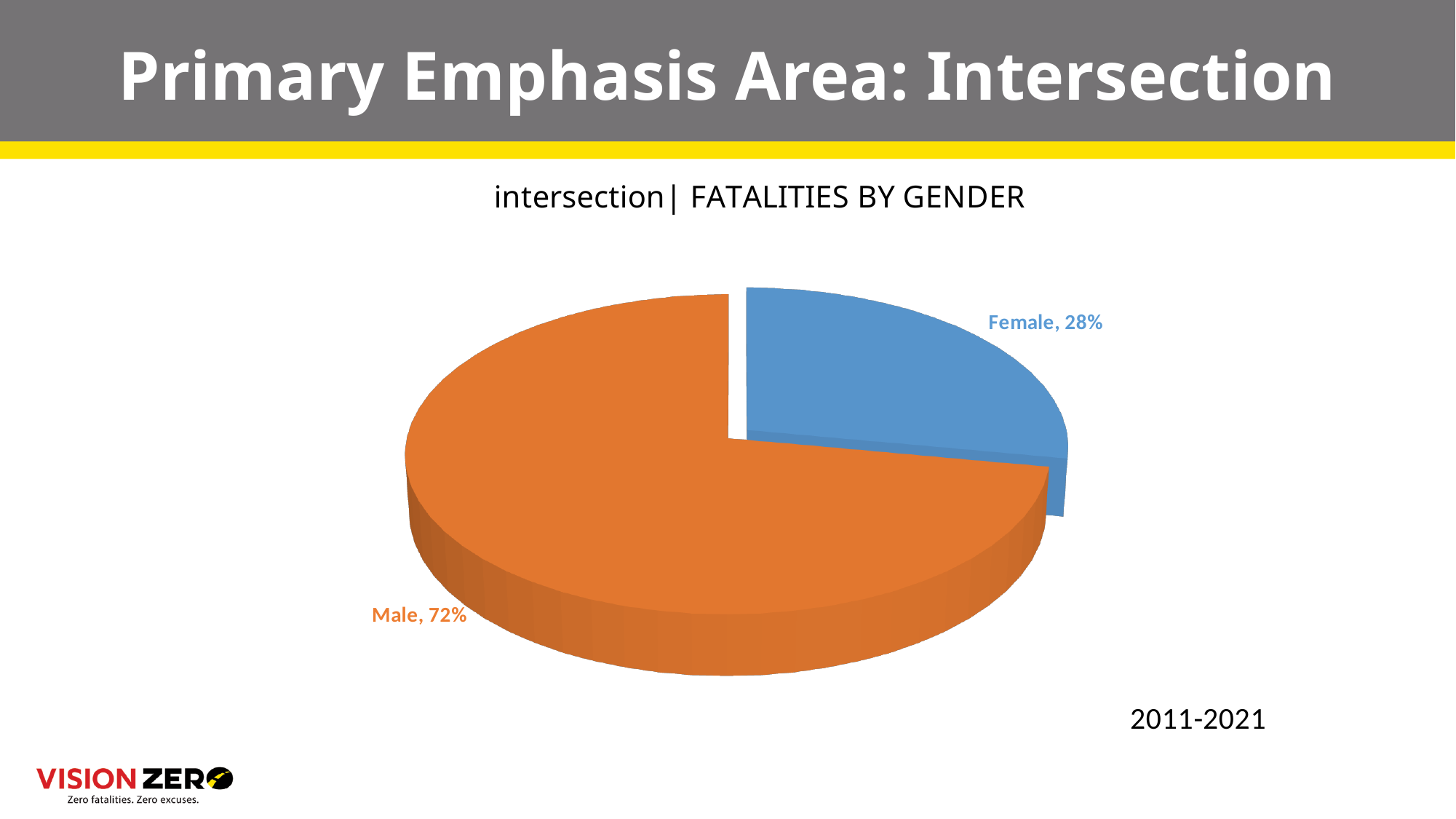
Which gender accounts for the smallest share of intersection fatalities? Female What kind of chart is shown on the slide? pie chart Which slice is larger, Male or Female? Male What is the title of the chart? intersection| FATALITIES BY GENDER What share of intersection fatalities were male? 72% How many slices does the pie chart have? 2 What time period does the chart cover? 2011-2021 Which gender accounts for the largest share of intersection fatalities? Male What is the total of the two slices' percentages? 100% What share of intersection fatalities were female? 28% What is the difference in percentage points between the male and female shares? 44